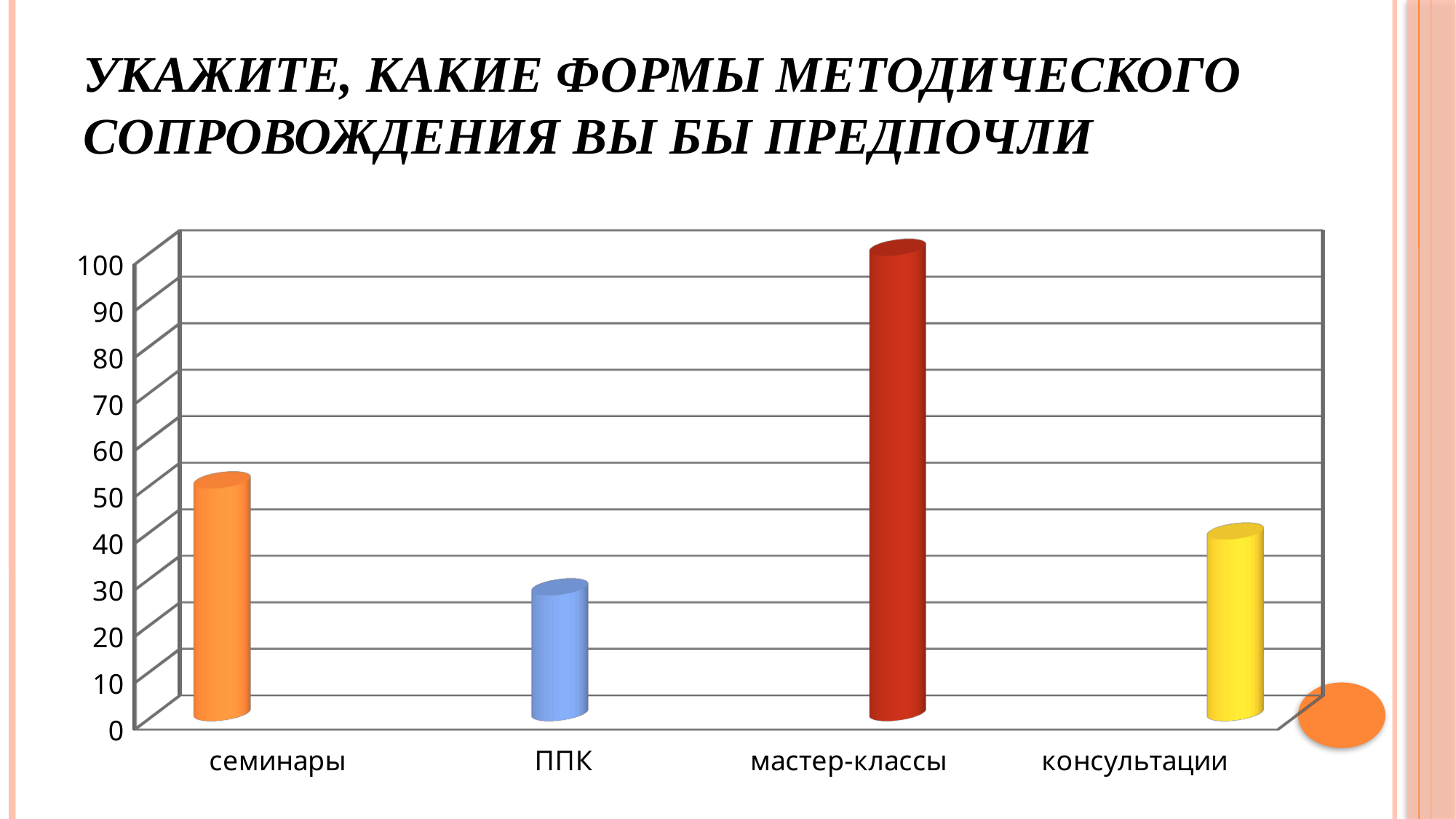
Which category has the lowest bar in the chart? ППК What kind of chart is shown on the slide? bar chart Is the value for консультации greater or less than 60? less What is the title of the slide containing the chart? УКАЖИТЕ, КАКИЕ ФОРМЫ МЕТОДИЧЕСКОГО СОПРОВОЖДЕНИЯ ВЫ БЫ ПРЕДПОЧЛИ Is the value for семинары greater or less than 60? less How many categories are shown on the x axis of the chart? 4 Is the value for ППК greater or less than 10? greater Which is larger, the value for семинары or the value for ППК? семинары Which category has the highest bar in the chart? мастер-классы